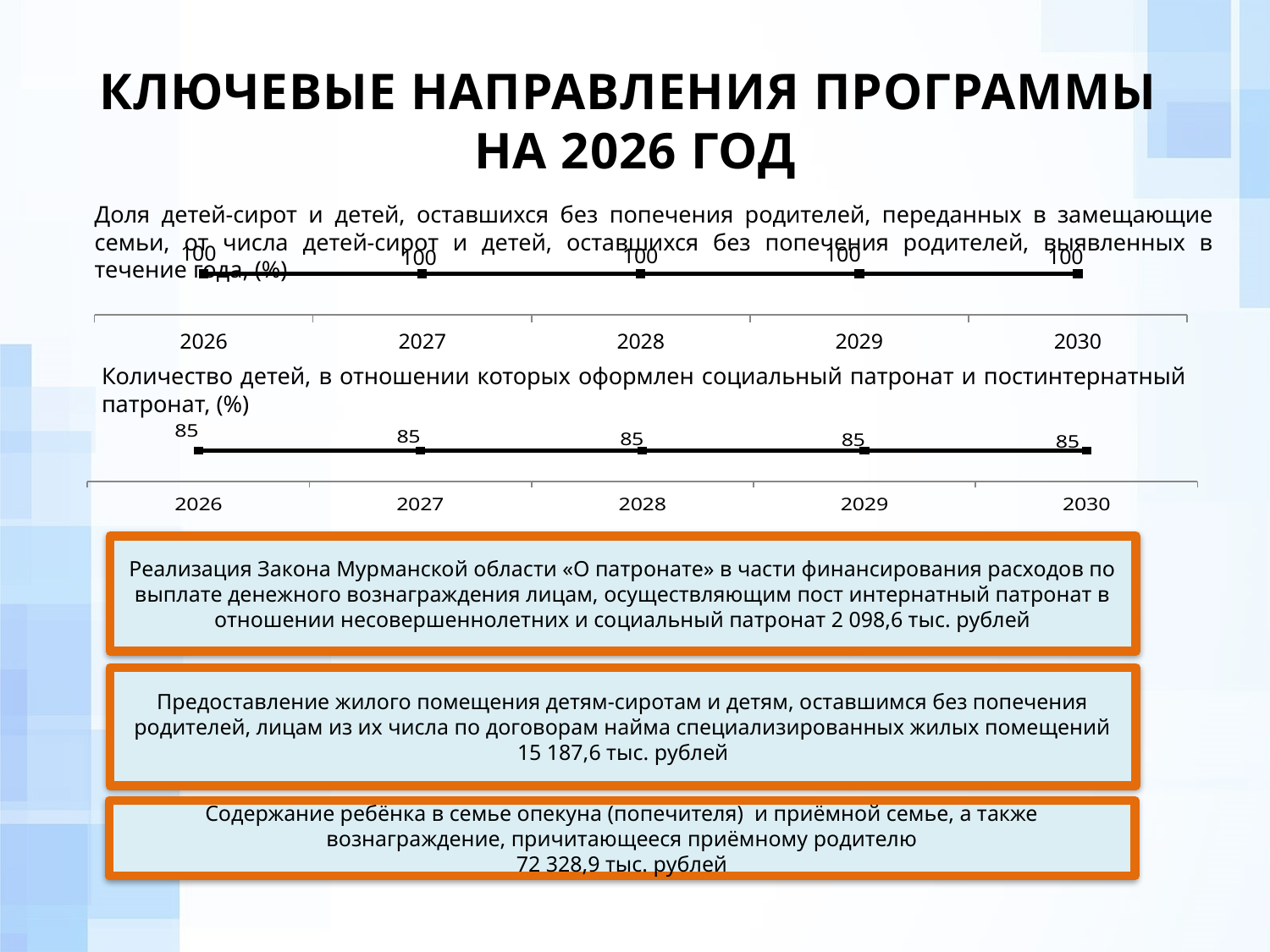
What type of chart is the top chart on the slide? line chart In the top chart, do the values rise, fall or stay flat from 2026 to 2030? stay flat What type of chart is the bottom chart on the slide? line chart In the bottom chart (children under social and post-institutional patronage), what is the value for 2030? 85 In the top chart (share of orphans placed in substitute families), what is the value for 2030? 100 In the top chart (share of orphans placed in substitute families), what is the value for 2026? 100 What is the difference between the 2028 value in the top chart and the 2028 value in the bottom chart? 15 How many data points does the bottom chart show? 5 Which is larger: the 2029 value in the top chart or the 2029 value in the bottom chart? the top chart (100) How many years are plotted on the top chart? 5 In the bottom chart, do the values rise, fall or stay flat from 2026 to 2030? stay flat In the bottom chart (children under social and post-institutional patronage), what is the value for 2027? 85